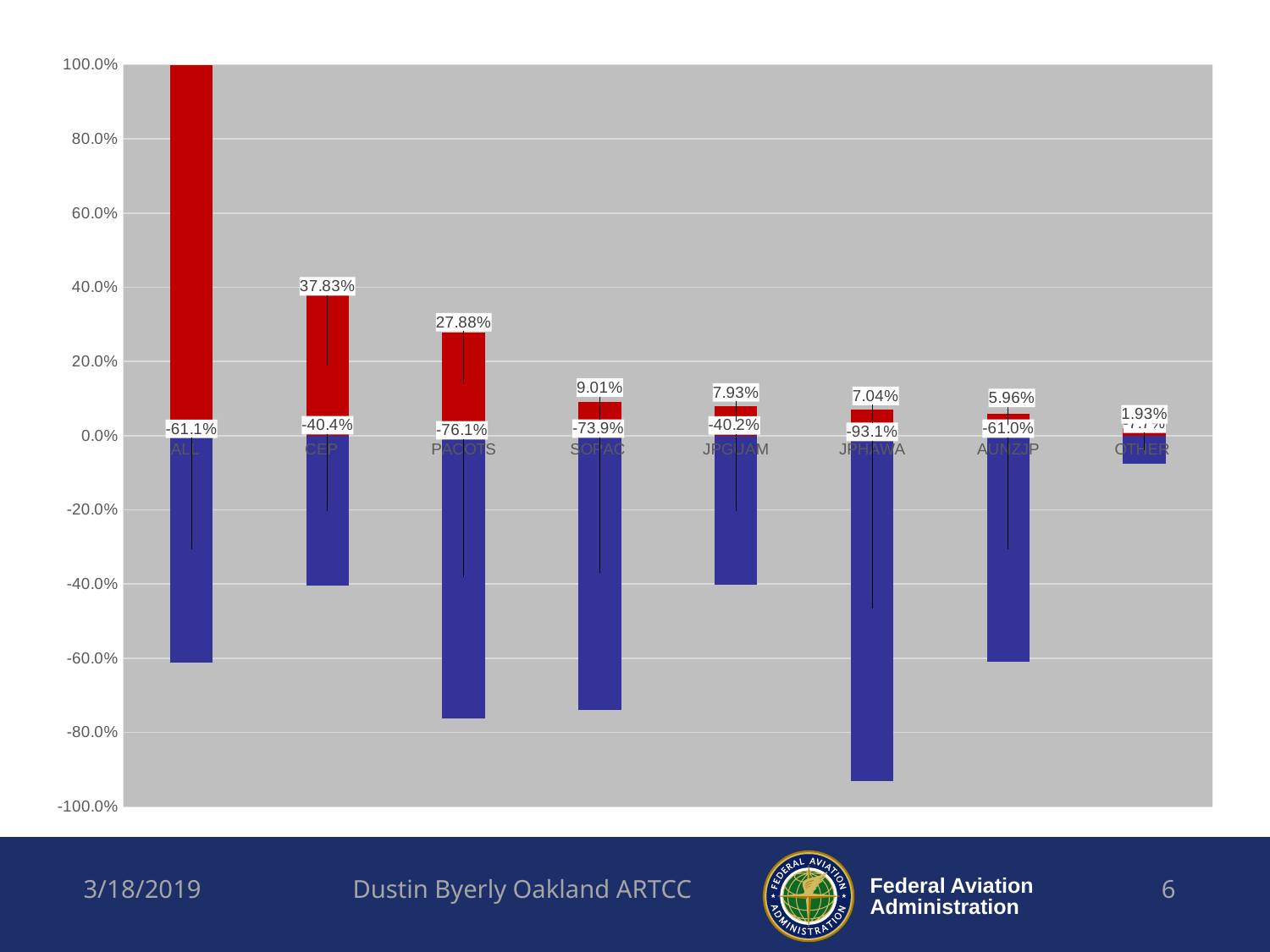
Which category has the tallest red bar? ALL Is the red bar for ALL greater or less than 80.0%? greater What is the value of the blue bar for ALL? -61.1% How many categories are shown on the x axis of the chart? 8 Which category has the lowest (most negative) blue bar? JPHAWA Do the red bar values rise or fall from CEP to OTHER along the x axis? fall What is the value of the red bar for PACOTS? 27.88% What is the value of the red bar for OTHER? 1.93% What is the value of the red bar for CEP? 37.83% What is the value of the blue bar for JPHAWA? -93.1% What kind of chart is shown on the slide? bar chart What is the difference between the red bar values for CEP and PACOTS? 9.95 percentage points